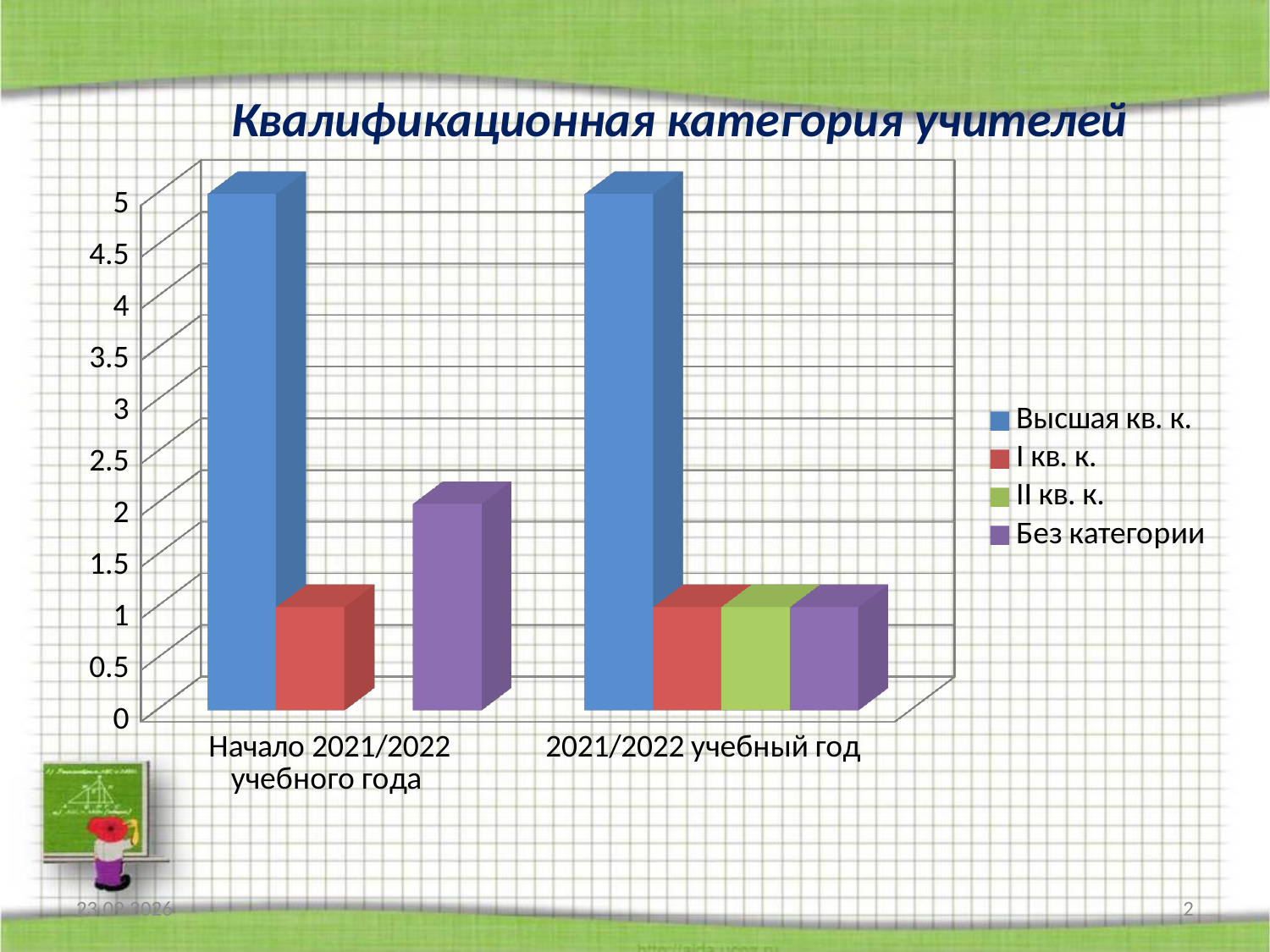
What kind of chart is shown on the slide? bar chart Which is larger for "Без категории": the value in "Начало 2021/2022 учебного года" or in "2021/2022 учебный год"? Начало 2021/2022 учебного года Which series is shown in green in the legend? II кв. к. Which is larger in "Начало 2021/2022 учебного года": the value for "Без категории" or the value for "I кв. к."? Без категории Is the value for "I кв. к." in "2021/2022 учебный год" greater or less than 2? less How many series does the legend list? 4 Is the value for "Без категории" in "Начало 2021/2022 учебного года" greater or less than 1.5? greater Is the value for "Высшая кв. к." in "Начало 2021/2022 учебного года" greater or less than 4? greater Which series has the highest value in the category "Начало 2021/2022 учебного года"? Высшая кв. к. What is the title of the chart? Квалификационная категория учителей Which series has the highest value in the category "2021/2022 учебный год"? Высшая кв. к. How many categories are shown on the x axis? 2